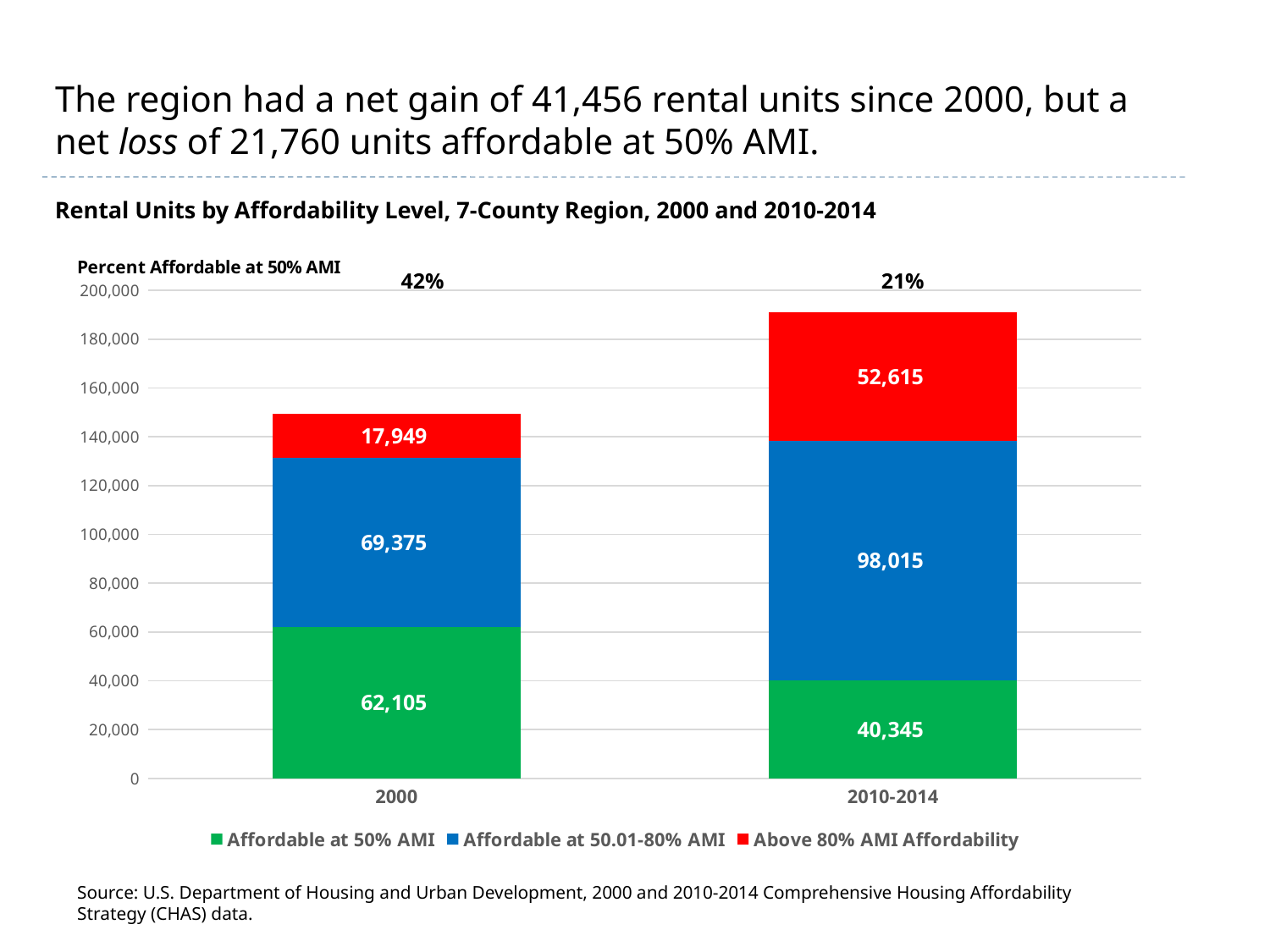
What is the title of the chart? Rental Units by Affordability Level, 7-County Region, 2000 and 2010-2014 What is the total of the stacked bar for 2010-2014? 190,975 What percent of rental units were affordable at 50% AMI in 2010-2014? 21% What is the value for Affordable at 50.01-80% AMI in 2010-2014? 98,015 What is the value for Affordable at 50% AMI in 2000? 62,105 What type of chart is shown on the slide? Stacked bar chart By how much did the number of units Affordable at 50% AMI decrease from 2000 to 2010-2014? 21,760 Which period has the larger value for Above 80% AMI Affordability, 2000 or 2010-2014? 2010-2014 How many series does the legend list? 3 How many categories are shown on the x axis? 2 What is the value for Above 80% AMI Affordability in 2010-2014? 52,615 What is the total of the stacked bar for 2000? 149,429